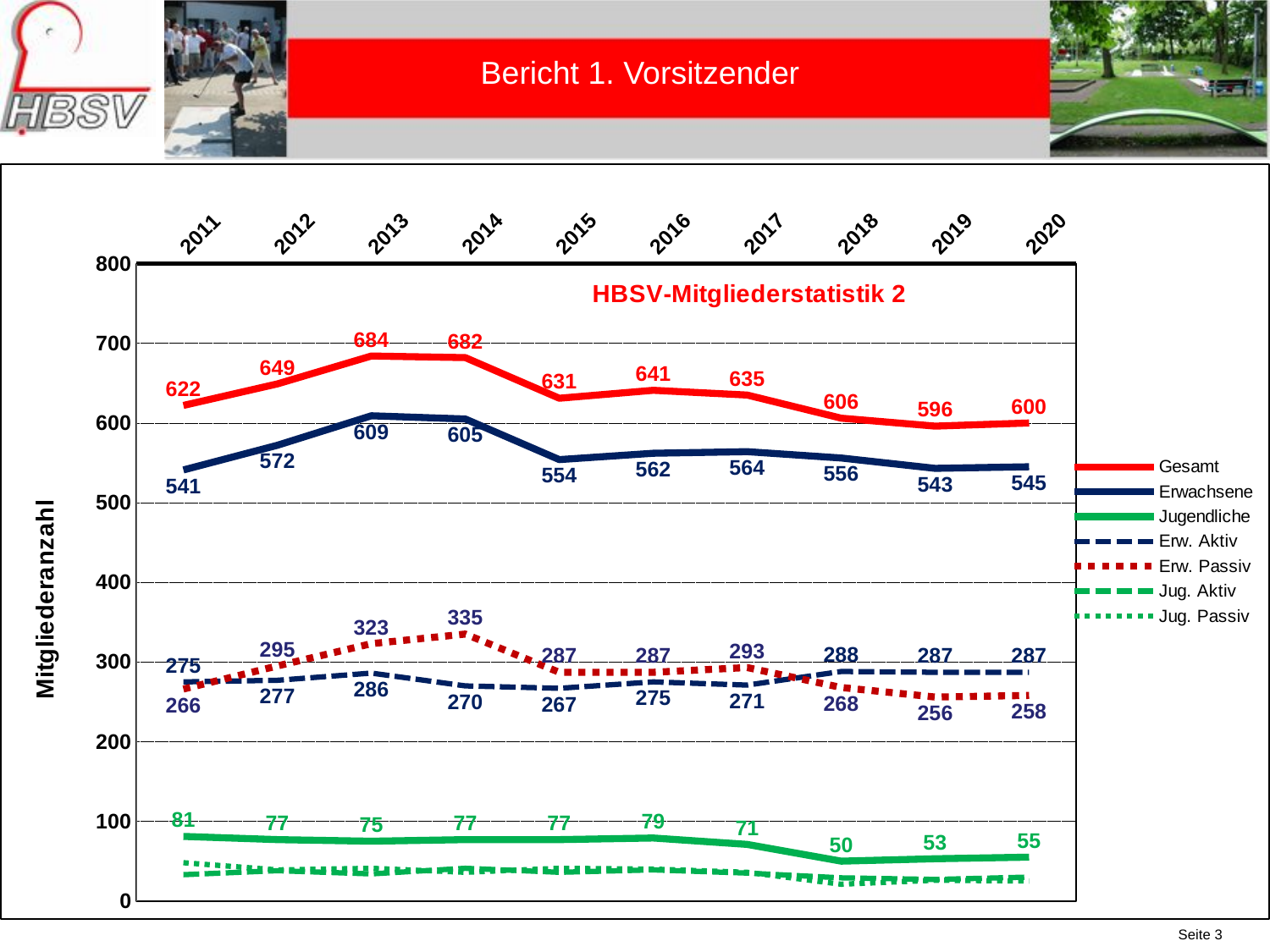
Which is larger, the Erwachsene value for 2012 or for 2016? 2012 Does the Gesamt series rise or fall from 2017 to 2019? Fall What is the lowest value of the Jugendliche series, and in which year? 50 in 2018 In which year is the Gesamt series lowest? 2019 What kind of chart is shown? Line chart How many series does the legend list? 7 What is the Gesamt value for 2013? 684 In which year is the Gesamt series highest? 2013 What is the Erw. Passiv value for 2014? 335 How many years are shown on the x axis? 10 What is the difference between the Gesamt values for 2013 and 2020? 84 What is the Erwachsene value for 2011? 541